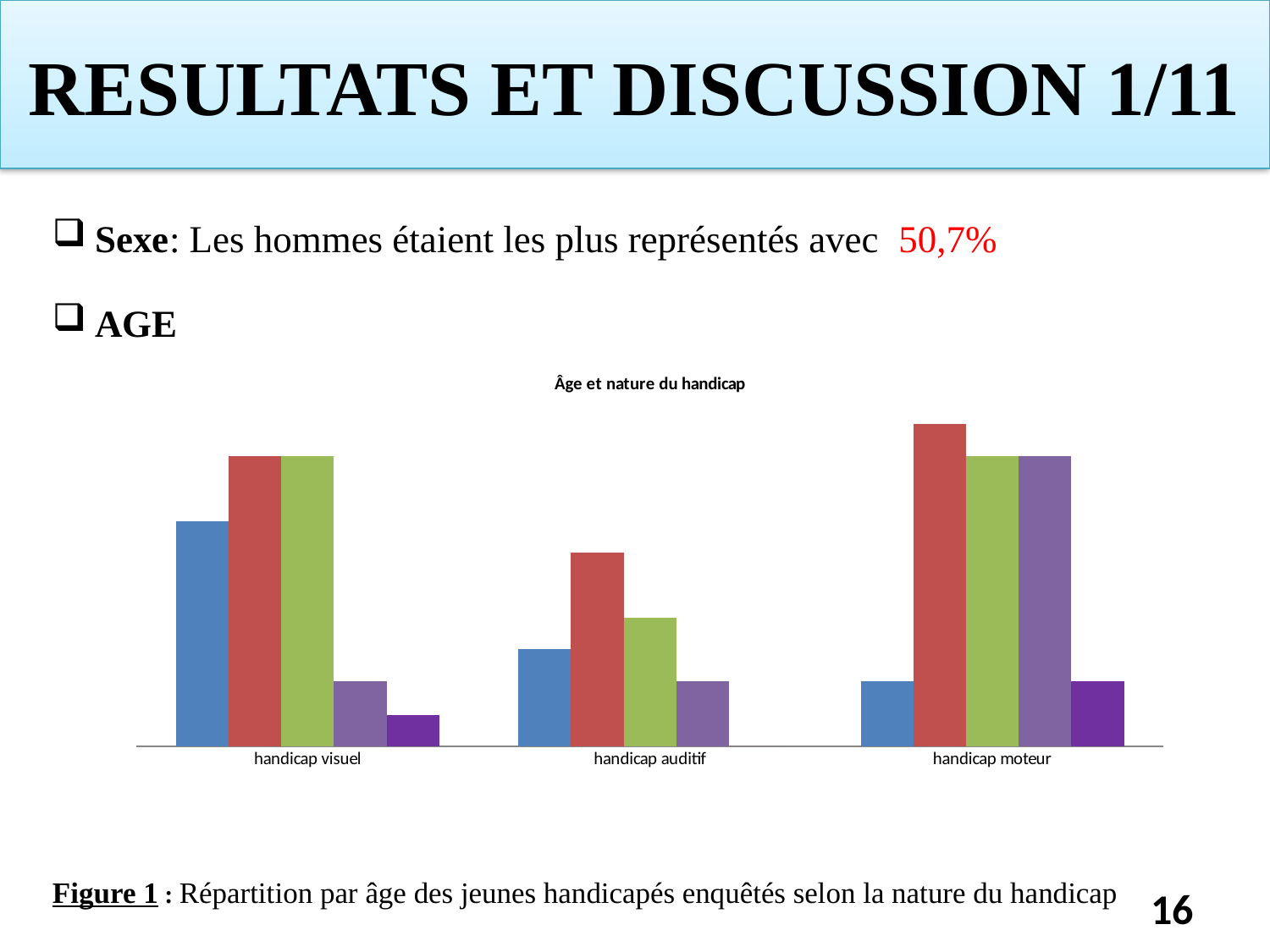
What is the title of the chart? Âge et nature du handicap Is the red bar for handicap moteur taller or shorter than the red bar for handicap visuel? taller Which category has the shortest red bar? handicap auditif How many categories are shown on the x axis of the chart? 3 Which category has the tallest blue bar? handicap visuel In the handicap auditif category, which bar is taller, the green bar or the purple bar? the green bar What kind of chart is shown on the slide? bar chart Which category has the shortest blue bar? handicap moteur In the handicap moteur category, which bar is taller, the red bar or the blue bar? the red bar What is the label of the middle category on the x axis? handicap auditif How many bars are shown for the handicap auditif category? 4 Which category on the x axis contains the tallest bar in the chart? handicap moteur